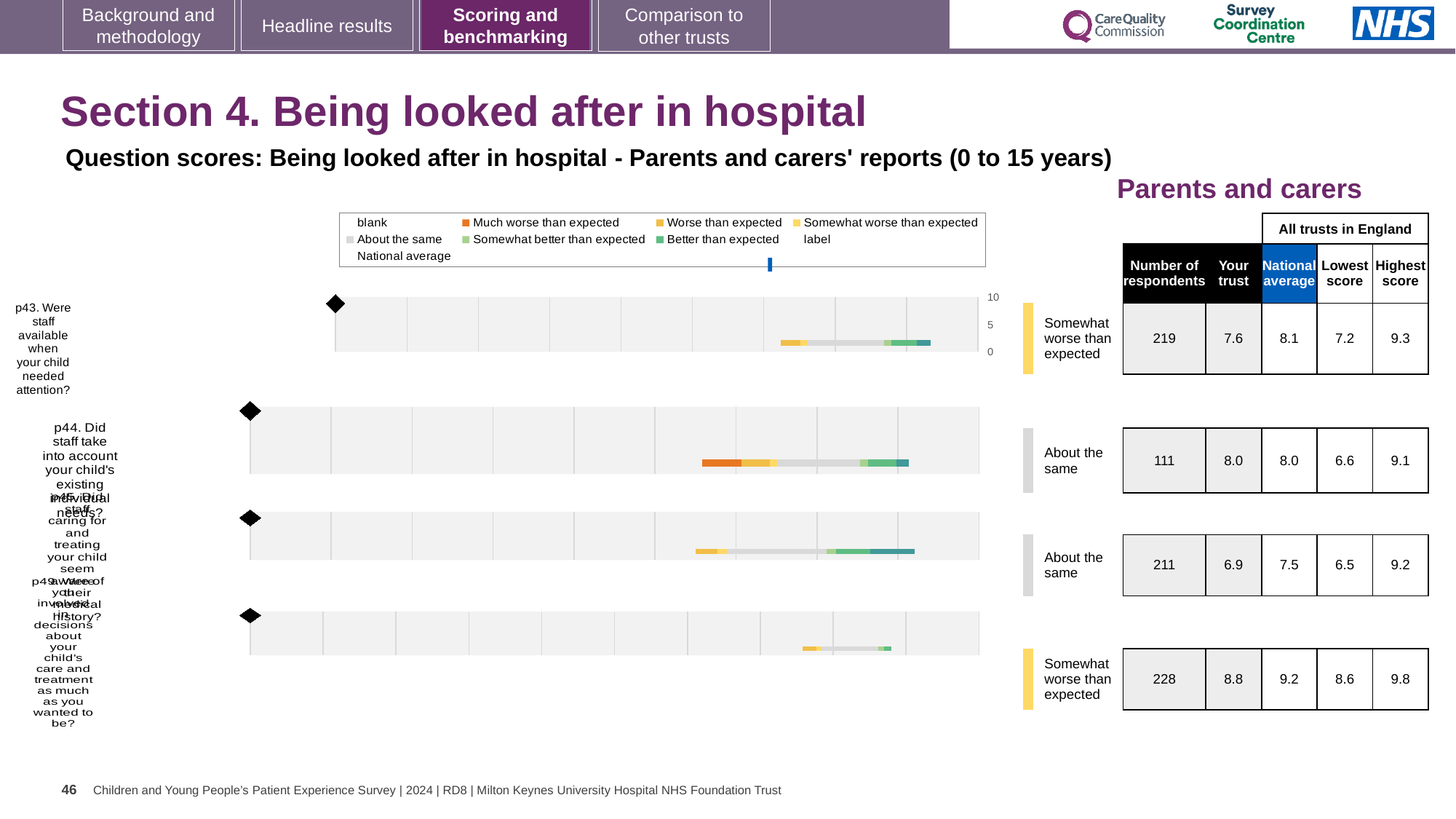
What benchmark category label is shown next to the p44 chart? About the same For the p43 chart (Were staff available when your child needed attention?), what is the 'Your trust' score? 7.6 For the p44 chart, what is the national average score? 8.0 How many question charts (p43, p44, p45, p49) are shown on the slide? 4 For the p49 chart, what is the highest score among all trusts in England? 9.8 Which question has the highest 'Your trust' score? p49 Which question has the lowest 'Your trust' score? p45 For p43, what is the difference between the highest score (9.3) and the lowest score (7.2)? 2.1 For the p45 chart, how many respondents are listed? 211 For p43, is the 'Your trust' score higher or lower than the national average? lower What benchmark category label is shown next to the p49 chart? Somewhat worse than expected What kind of chart is used to show the benchmarking for question p43? bar chart